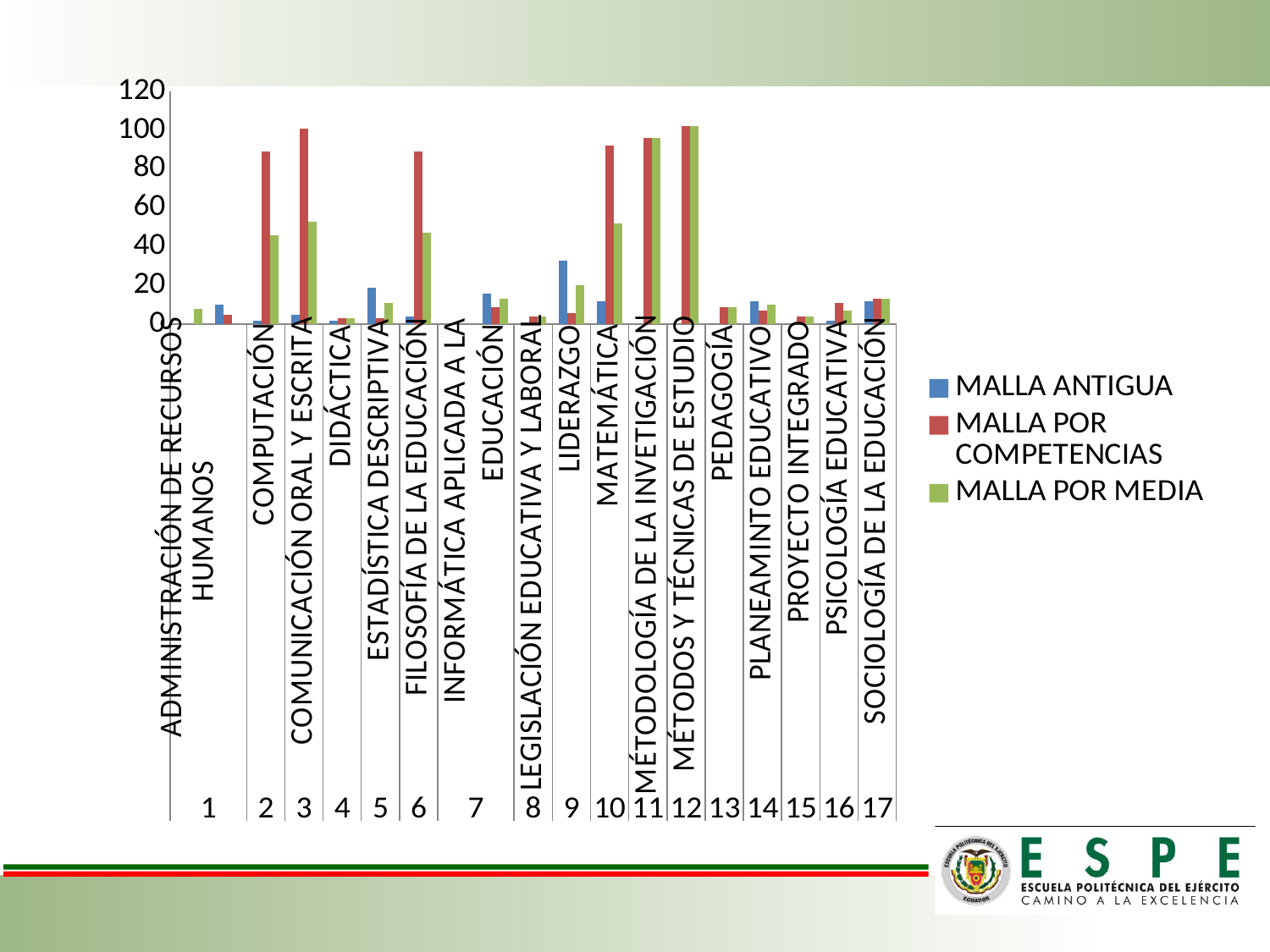
Is the MALLA POR MEDIA value for FILOSOFÍA DE LA EDUCACIÓN greater or less than 60? less For LIDERAZGO, which is larger: MALLA ANTIGUA or MALLA POR MEDIA? MALLA ANTIGUA Is the MALLA POR COMPETENCIAS value for COMPUTACIÓN greater or less than 80? greater Which category has the highest value for MALLA ANTIGUA? LIDERAZGO Is the MALLA POR COMPETENCIAS value for MATEMÁTICA greater or less than 80? greater For FILOSOFÍA DE LA EDUCACIÓN, which is larger: MALLA POR COMPETENCIAS or MALLA POR MEDIA? MALLA POR COMPETENCIAS What colour represents the MALLA POR MEDIA series in the legend? green How many categories are plotted along the x axis? 17 For COMPUTACIÓN, which is larger: MALLA POR COMPETENCIAS or MALLA POR MEDIA? MALLA POR COMPETENCIAS What kind of chart is shown on the slide? bar chart How many series does the legend list? 3